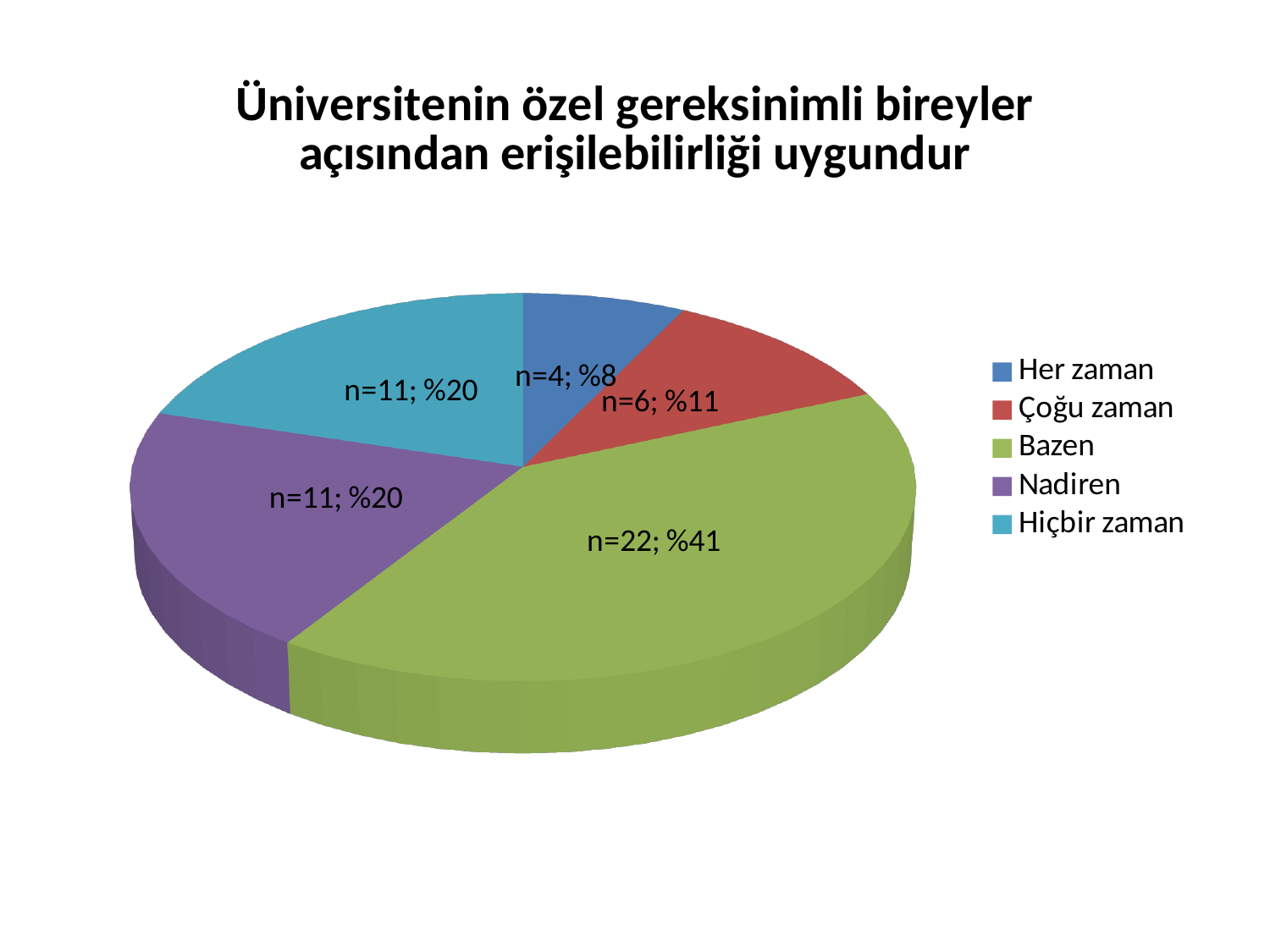
What is the data label for the Bazen slice? n=22; %41 How many categories does the legend list? 5 What type of chart is shown on the slide? pie chart What is the difference in n between the Bazen slice and the Çoğu zaman slice? 16 Which category has the smallest slice? Her zaman What is the title of the chart? Üniversitenin özel gereksinimli bireyler açısından erişilebilirliği uygundur Which category has the largest slice? Bazen What is the data label for the Nadiren slice? n=11; %20 What is the data label for the Her zaman slice? n=4; %8 Which is larger, the Çoğu zaman slice or the Nadiren slice? Nadiren What is the data label for the Çoğu zaman slice? n=6; %11 What share of the pie does the Hiçbir zaman slice represent? %20